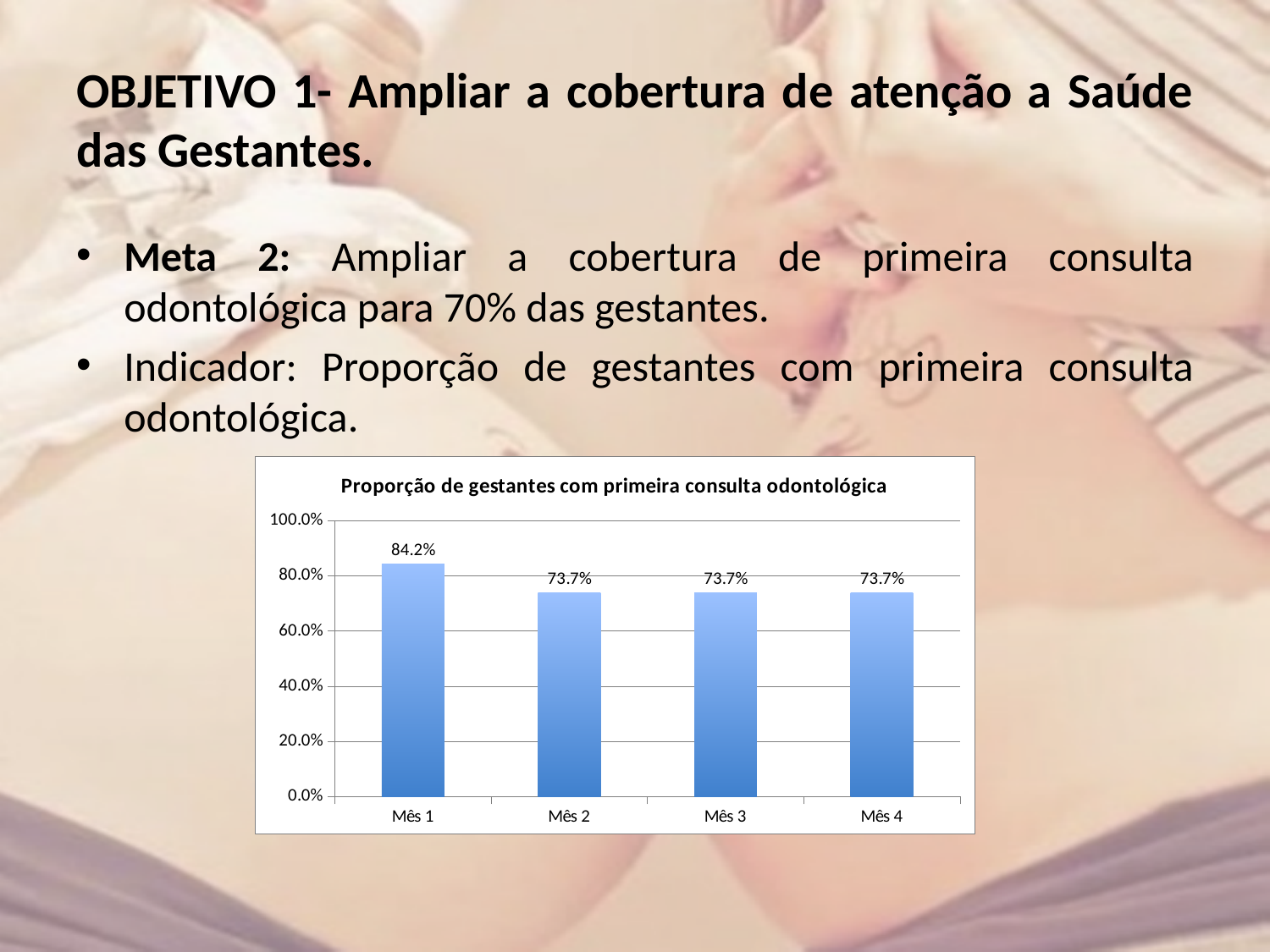
Do the values rise or fall from Mês 1 to Mês 2? fall Which month has the highest value? Mês 1 Which is larger, the value for Mês 1 or the value for Mês 4? Mês 1 What is the highest value shown on the y axis? 100.0% Is the value for Mês 1 greater or less than 80.0%? greater How many months are shown on the x axis? 4 What is the value for Mês 3? 73.7% What kind of chart is shown? bar chart What is the value for Mês 1? 84.2% What is the title of the chart? Proporção de gestantes com primeira consulta odontológica What is the difference between the values for Mês 1 and Mês 2? 10.5% Is the value for Mês 2 greater or less than 80.0%? less